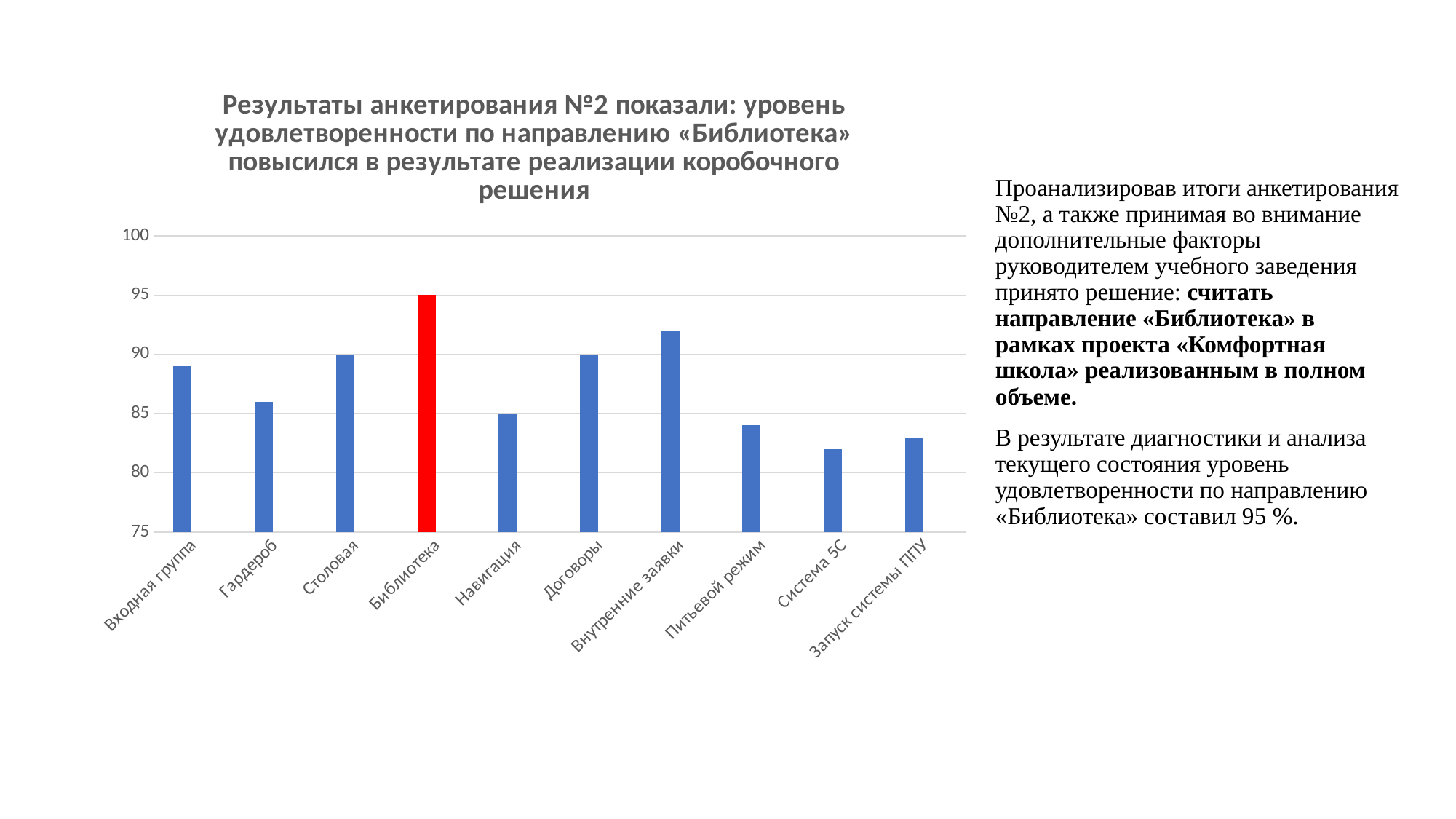
Which is larger, the value for Библиотека or the value for Внутренние заявки? Библиотека What is the value for Столовая? 90 Which bar in the chart is coloured red? Библиотека What type of chart is shown on the slide? bar chart Which category has the highest value? Библиотека What is the value for Библиотека? 95 What is the value for Договоры? 90 What is the difference between the values for Библиотека and Навигация? 10 How many categories are shown on the x axis of the chart? 10 Is the value for Система 5С greater or less than 85? less Is the value for Внутренние заявки greater or less than 90? greater What is the value for Навигация? 85